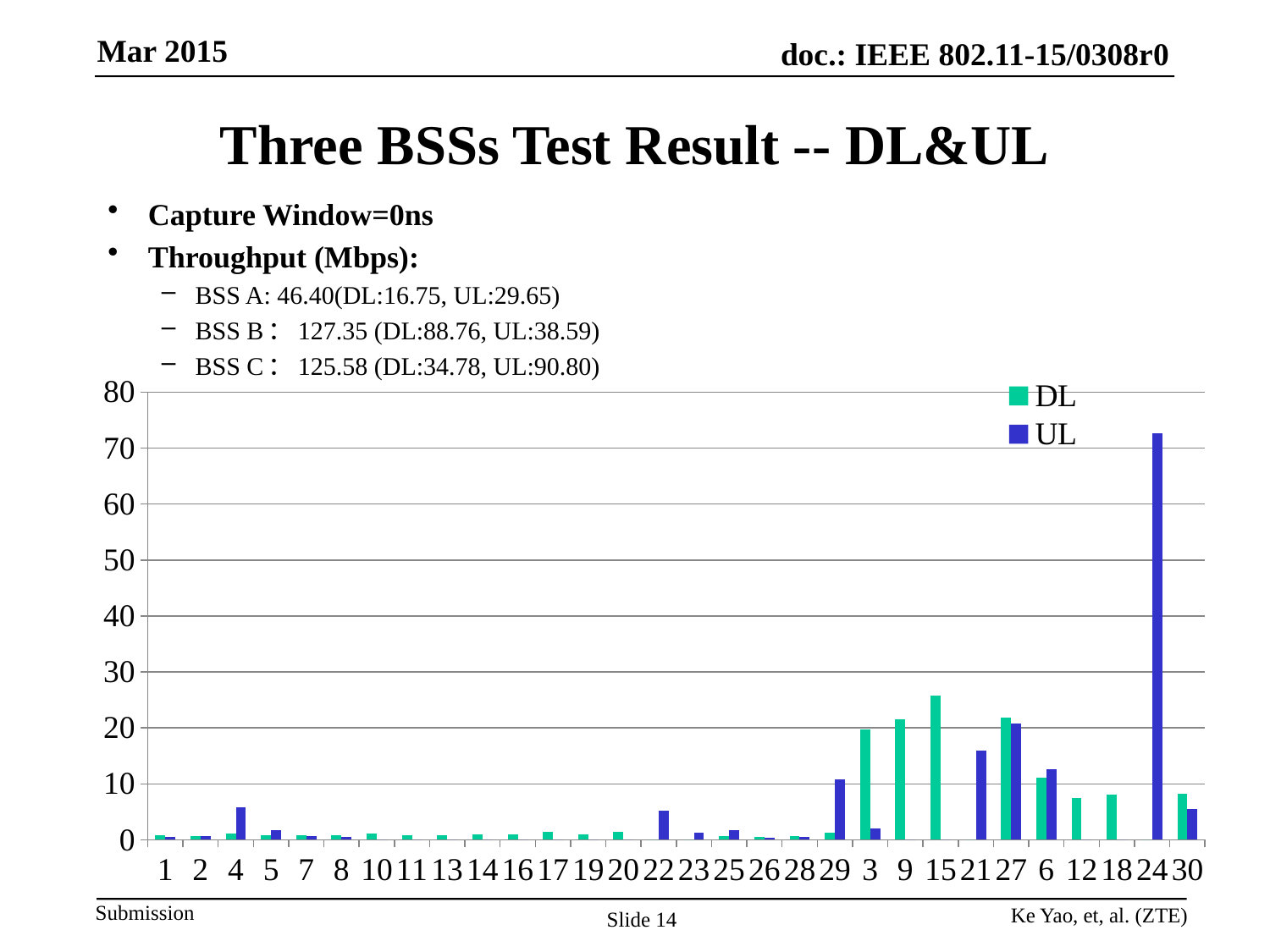
How many series does the chart legend list? 2 How many categories are shown along the x axis of the chart? 30 What kind of chart is shown on the slide? bar chart Is the UL value for category 24 greater or less than 60? greater Which category has the highest DL value? 15 Is the DL value for category 15 greater or less than 20? greater Is the UL value for category 21 greater or less than 10? greater What are the two series named in the chart legend? DL and UL Which category has the highest UL value? 24 Which colour represents the UL series in the chart? blue Which is larger, the DL value for category 15 or the DL value for category 3? category 15